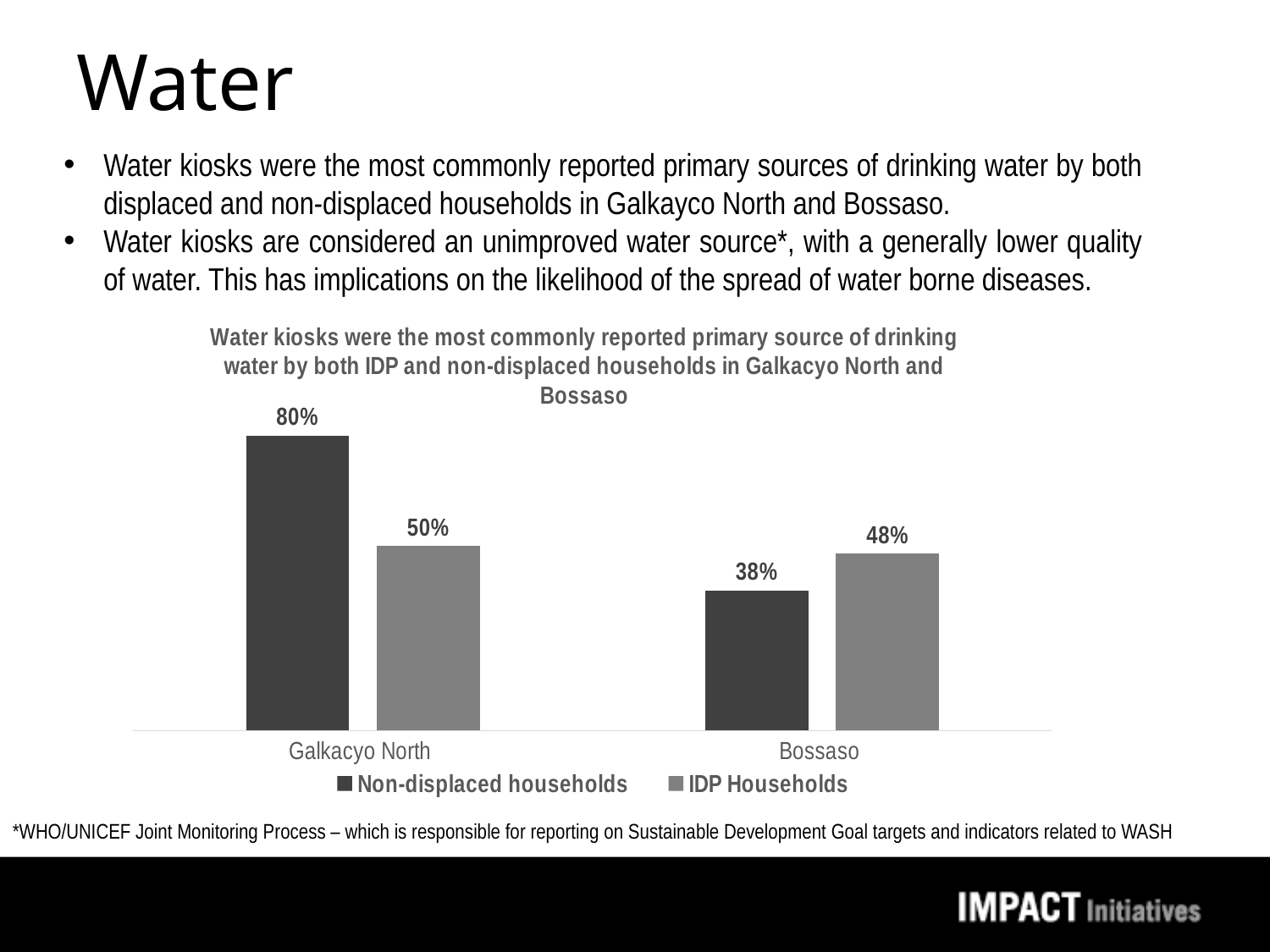
In Bossaso, which is larger: the value for Non-displaced households or for IDP Households? IDP Households What is the difference between IDP Households and Non-displaced households in Bossaso? 10% What is the value for Non-displaced households in Bossaso? 38% What percentage of non-displaced households in Galkacyo North reported water kiosks as their primary source of drinking water? 80% What is the difference between Non-displaced households and IDP Households in Galkacyo North? 30% What is the value for IDP Households in Galkacyo North? 50% How many series does the chart legend list? 2 Which bar in the chart has the lowest value? Non-displaced households in Bossaso What is the value for IDP Households in Bossaso? 48% What type of chart is shown on the slide? Bar chart How many locations are shown on the x axis of the chart? 2 Which location has the highest value for Non-displaced households? Galkacyo North